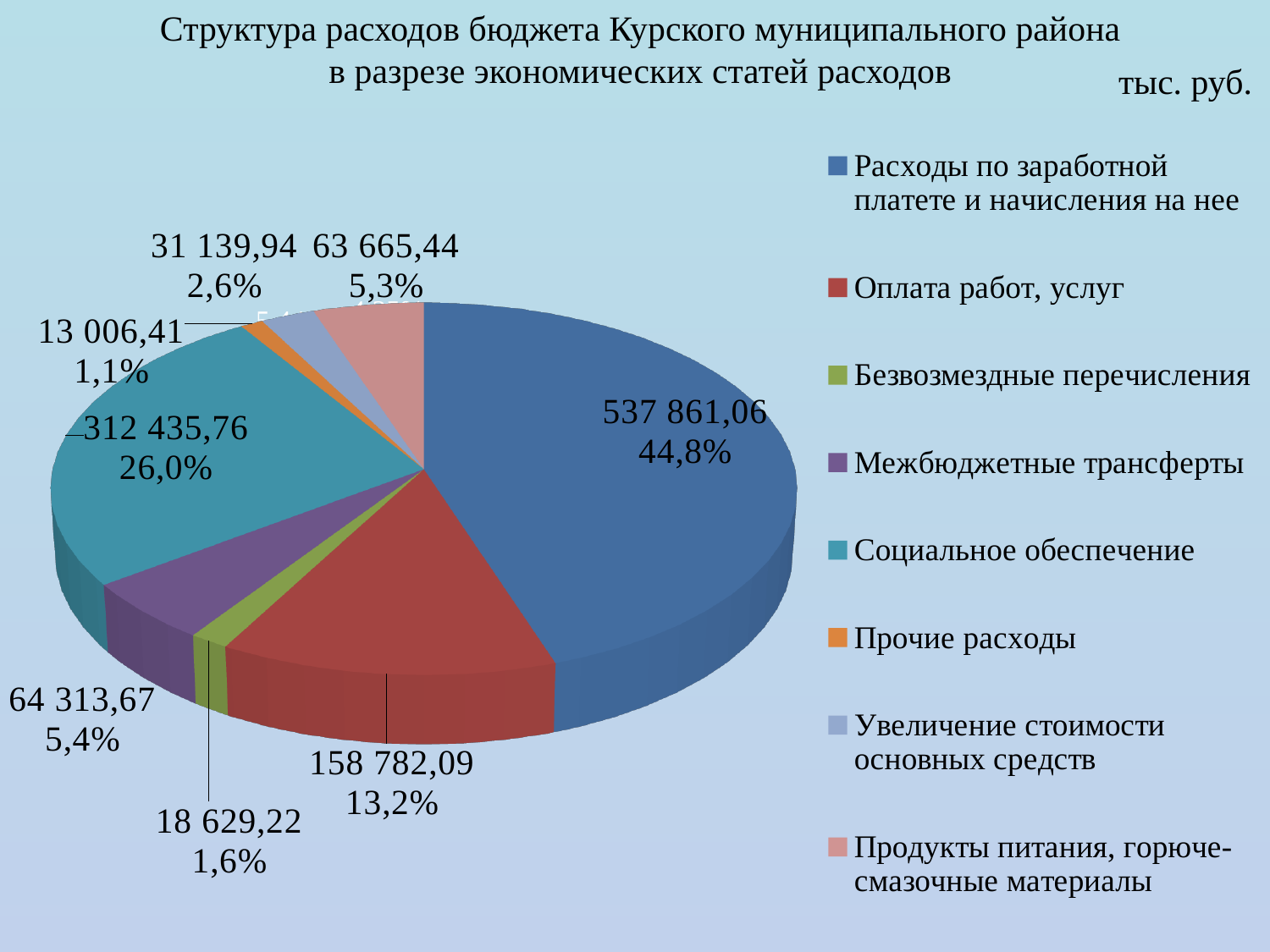
What is the value for "Расходы по заработной платете и начисления на нее"? 537 861,06 What share of the pie does "Прочие расходы" represent? 1,1% What share of the pie does "Межбюджетные трансферты" represent? 5,4% What is the value for "Продукты питания, горюче-смазочные материалы"? 63 665,44 What share of the pie does "Социальное обеспечение" represent? 26,0% Which category has the smallest slice of the pie? Прочие расходы What is the value for "Оплата работ, услуг"? 158 782,09 Which category has the largest slice of the pie? Расходы по заработной платете и начисления на нее How many categories does the legend of the pie chart list? 8 Which is larger: "Безвозмездные перечисления" or "Увеличение стоимости основных средств"? Увеличение стоимости основных средств What unit is indicated for the values in the chart? тыс. руб. What type of chart is shown on the slide? Pie chart